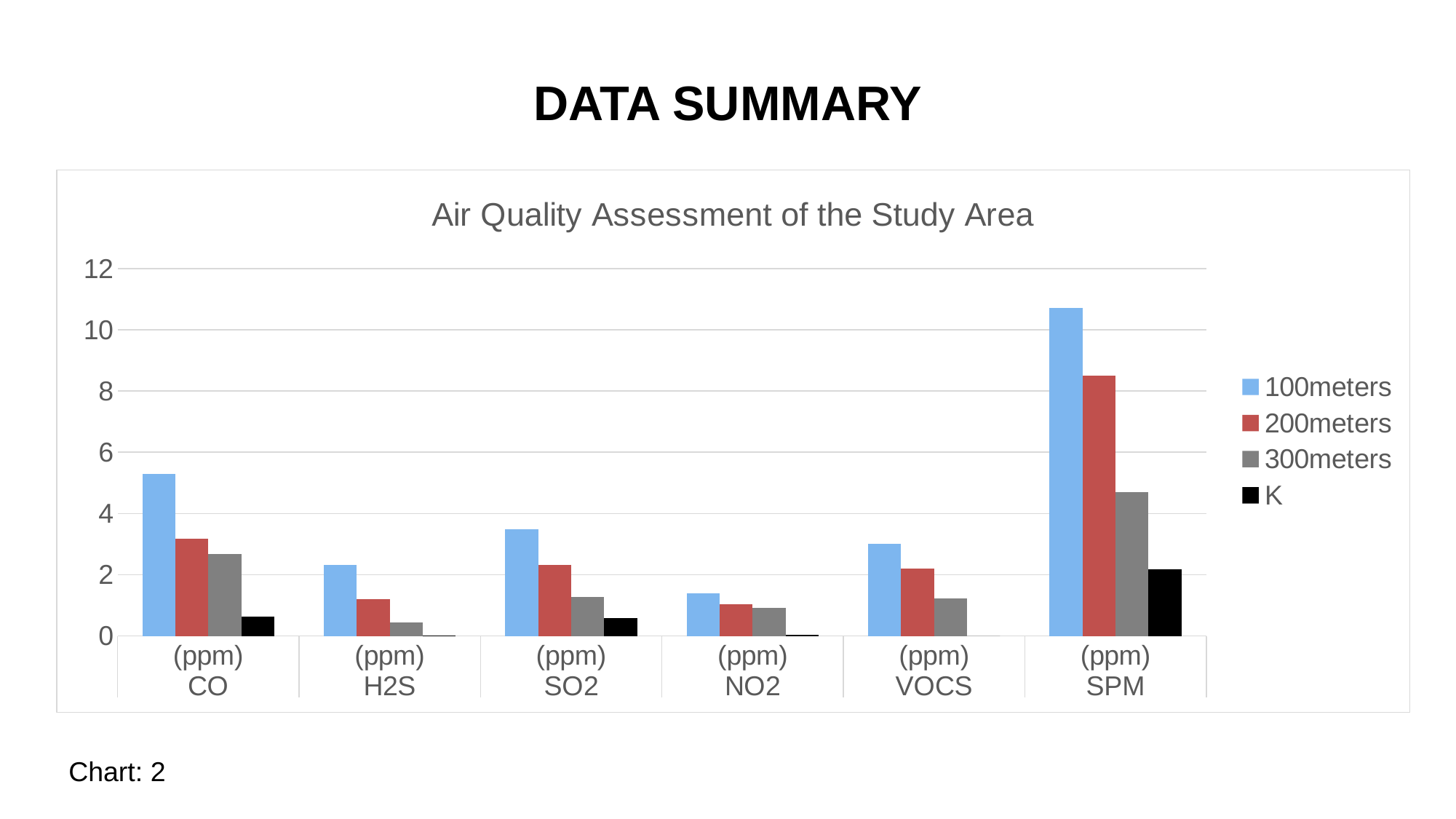
Is the 100meters value for SPM greater or less than 10? greater What kind of chart is shown on the slide? bar chart Which category has the highest value for the K series? SPM Which category has the highest value for the 100meters series? SPM Is the 100meters value for CO greater or less than 4? greater Which category has the lowest value for the 100meters series? NO2 Is the 200meters value for H2S greater or less than 2? less How many series does the legend list? 4 Which is larger for SO2: the 100meters value or the 300meters value? 100meters Which series is shown in black in the legend? K What is the title of the chart? Air Quality Assessment of the Study Area How many pollutant categories are shown on the x axis? 6